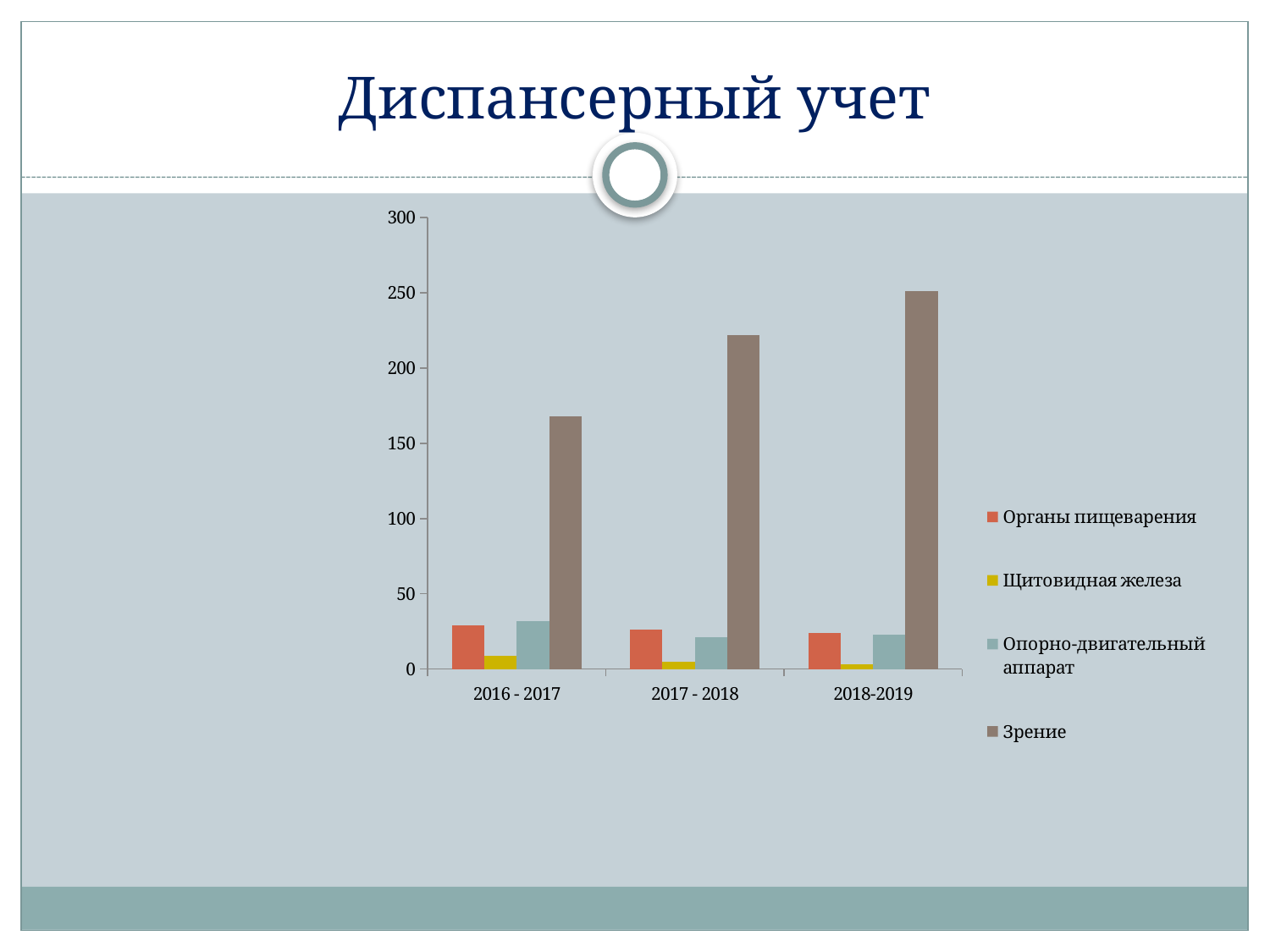
What is the title of the slide containing the chart? Диспансерный учет What kind of chart is shown on the slide? bar chart Is the value for Органы пищеварения in 2016 - 2017 greater or less than 50? less In which period is the value for Зрение the highest? 2018-2019 Which series has the lowest bar in 2016 - 2017? Щитовидная железа Which is larger: the value for Зрение in 2017 - 2018 or in 2016 - 2017? 2017 - 2018 Which series has the highest bar in every period? Зрение Do the values for Зрение rise or fall from 2016 - 2017 to 2018-2019? rise Is the value for Зрение in 2016 - 2017 greater or less than 150? greater Is the value for Зрение in 2017 - 2018 greater or less than 200? greater How many series does the legend list? 4 How many categories (periods) are shown on the x axis? 3